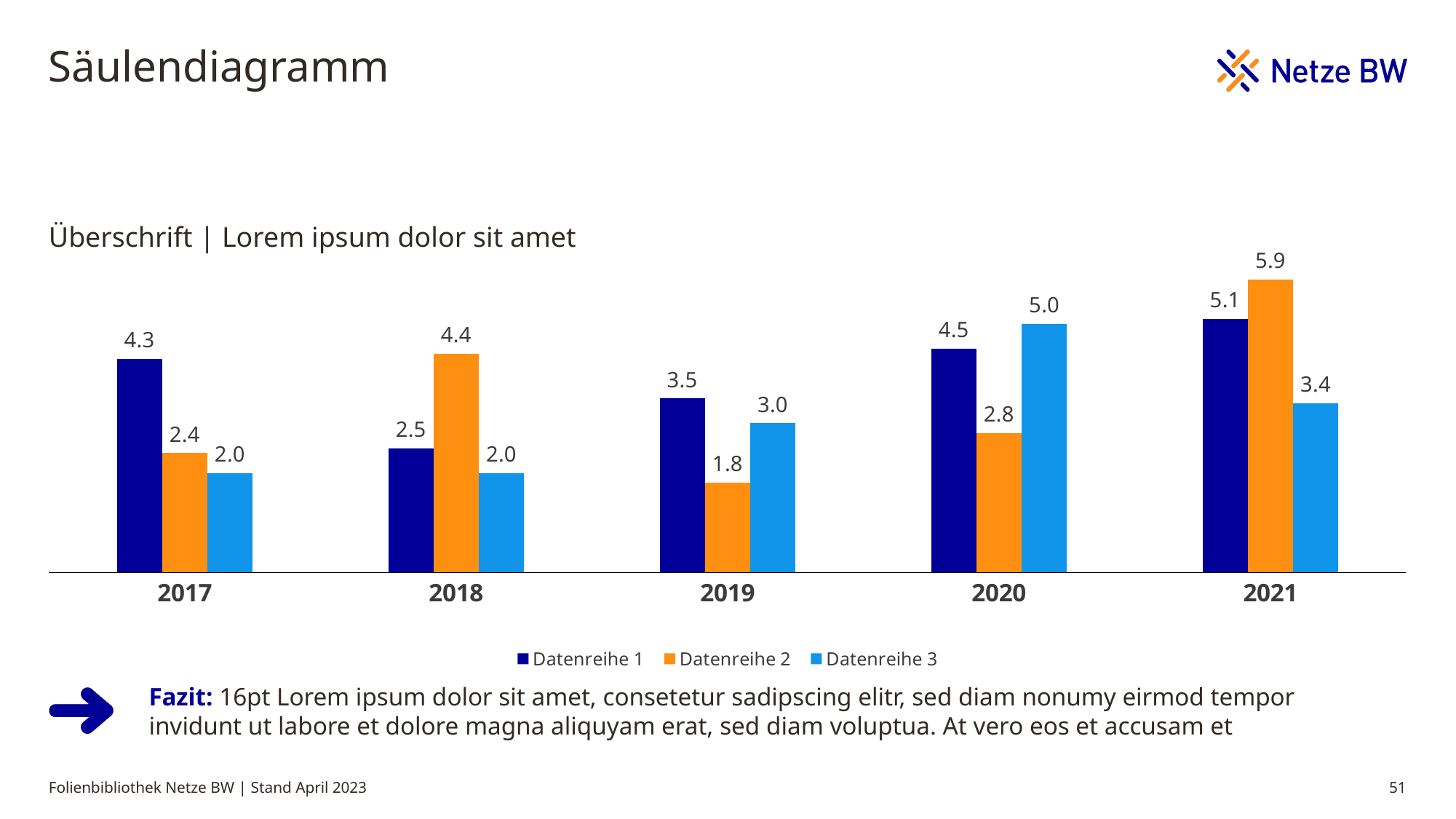
What is the value of Datenreihe 2 in 2018? 4.4 Which year has the lowest value for Datenreihe 1? 2018 Does Datenreihe 3 rise or fall from 2019 to 2020? Rise What is the value of Datenreihe 3 in 2020? 5.0 Which year has the highest value for Datenreihe 2? 2021 What is the difference between Datenreihe 2 and Datenreihe 1 in 2021? 0.8 How many years are shown on the x axis? 5 In 2019, which is larger: Datenreihe 1 or Datenreihe 3? Datenreihe 1 How many series does the legend list? 3 What is the value of Datenreihe 1 in 2017? 4.3 What kind of chart is shown on the slide? Bar chart What is the title of the slide? Säulendiagramm